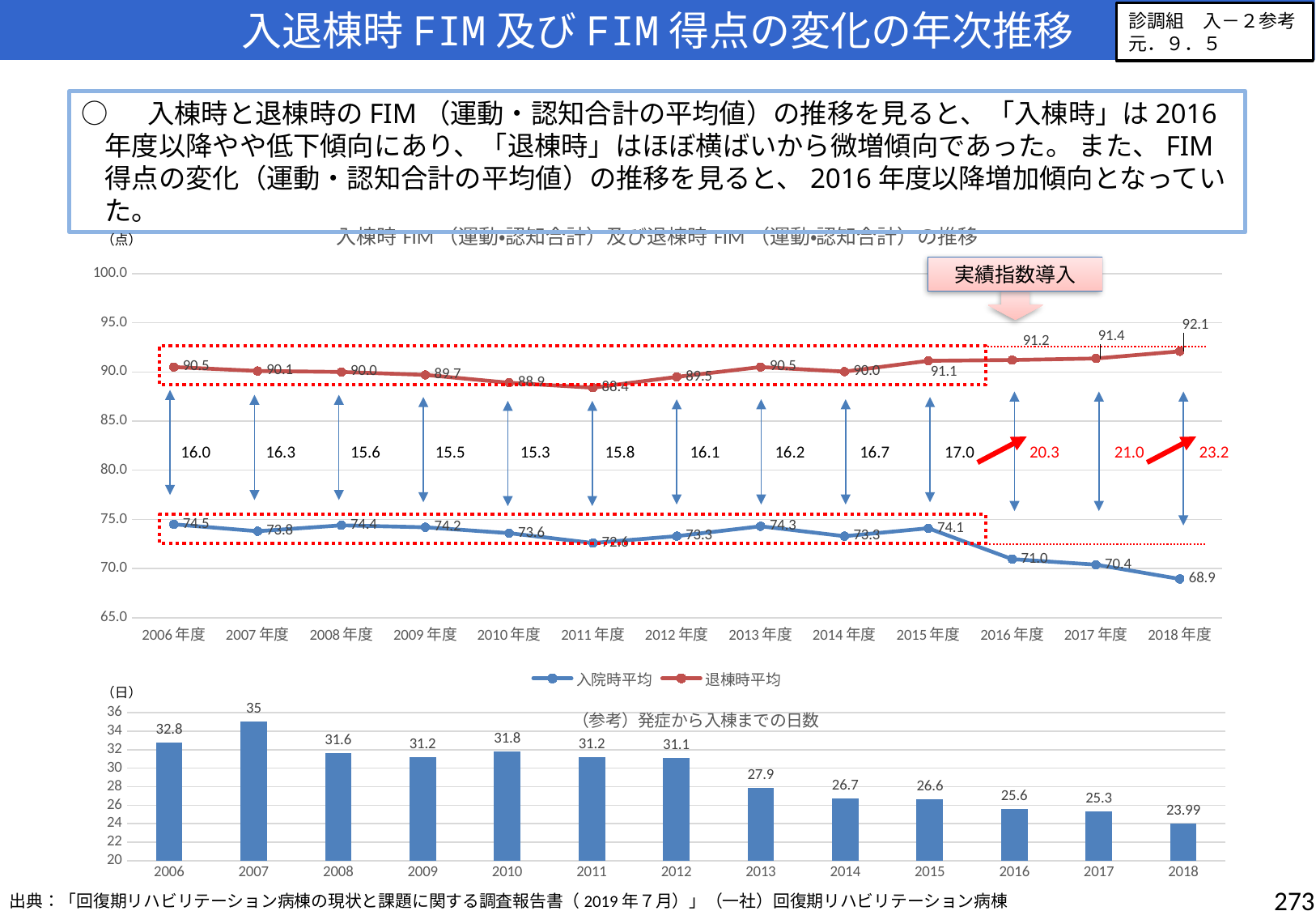
In the bottom bar chart (（参考）発症から入棟までの日数), what is the value for 2007? 35 In the bottom bar chart (（参考）発症から入棟までの日数), which year has the lowest value? 2018 In the top line chart, how many series does the legend list? 2 In the bottom bar chart (（参考）発症から入棟までの日数), what is the value for 2018? 23.99 In the bottom bar chart (（参考）発症から入棟までの日数), what is the difference between the 2006 value and the 2013 value? 4.9 In the bottom bar chart (（参考）発症から入棟までの日数), how many years are shown? 13 What type of chart is the bottom chart (（参考）発症から入棟までの日数)? bar chart In the top line chart, what is the 退棟時平均 value for 2018年度? 92.1 In the top line chart, which year has the lowest 入院時平均 value? 2018年度 In the top line chart, does the 入院時平均 series rise or fall from 2015年度 to 2018年度? fall In the top line chart, what is the 入院時平均 value for 2011年度? 72.6 In the bottom bar chart (（参考）発症から入棟までの日数), which year has the highest value? 2007